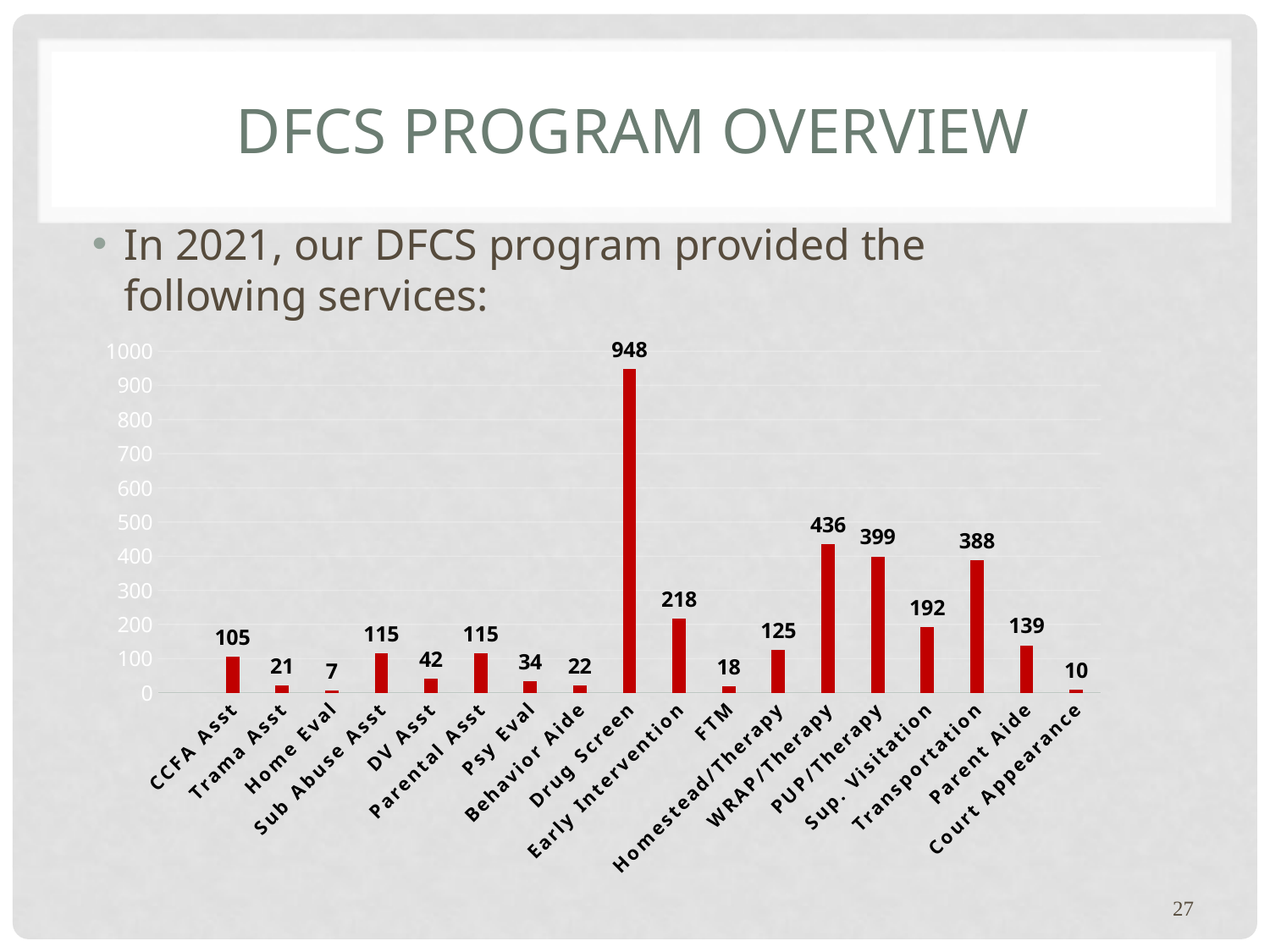
What is the value for Court Appearance? 10 What is the difference between the values for Early Intervention and Parent Aide? 79 How many categories are shown on the x axis? 18 What is the highest value shown on the y axis? 1000 Which category has the highest value? Drug Screen What is the value for Sup. Visitation? 192 What is the difference between the values for WRAP/Therapy and PUP/Therapy? 37 What kind of chart is shown on the slide? Bar chart Which category has the lowest value? Home Eval What is the value for Drug Screen? 948 Which is larger, the value for Transportation or the value for Early Intervention? Transportation What is the value for WRAP/Therapy? 436